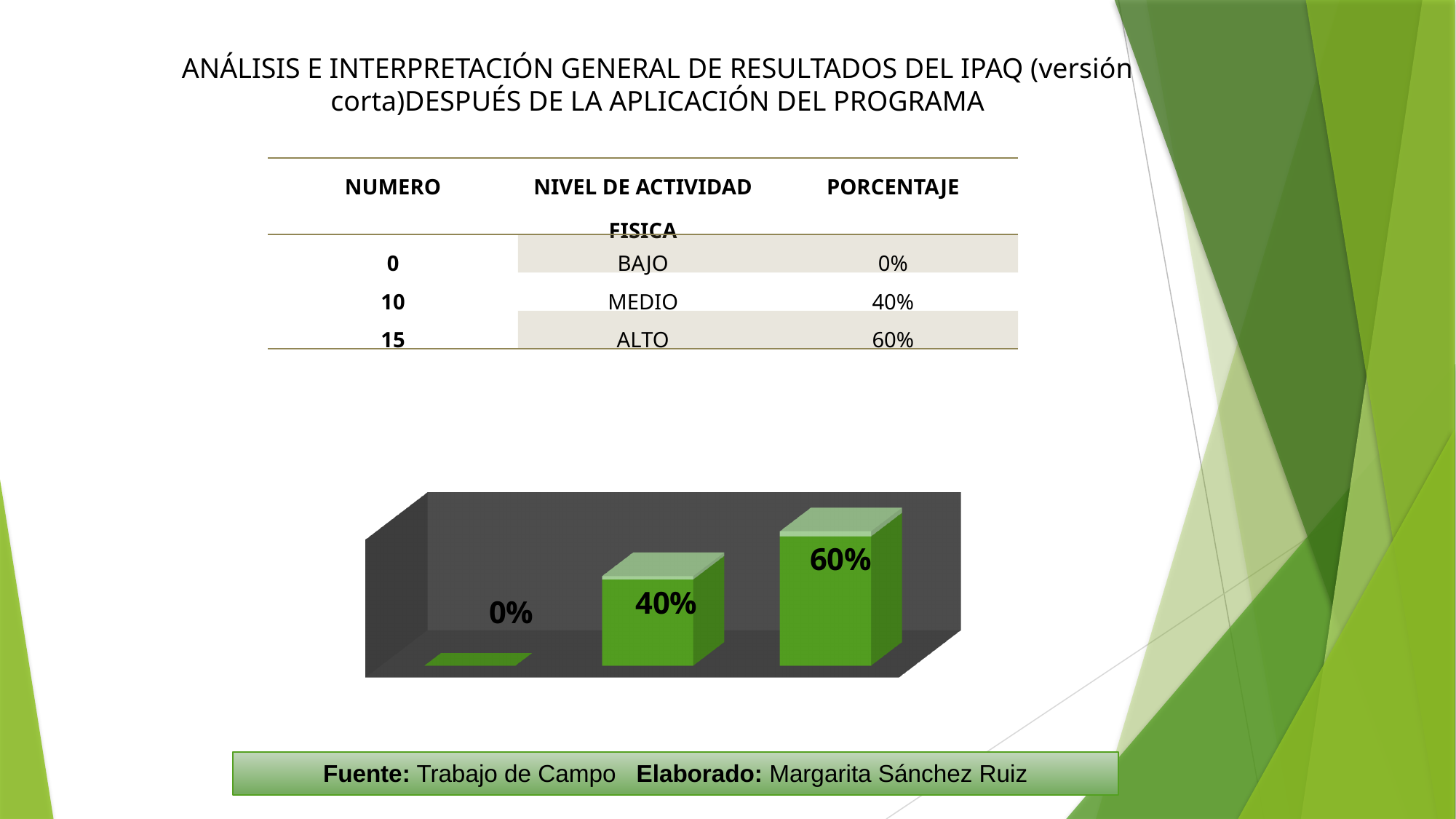
How many bars are plotted in the chart? 3 What is the value shown on the middle bar of the chart? 40% What is the difference between the values of the middle bar and the leftmost bar? 40% Which is larger, the value of the middle bar or the value of the rightmost bar? the rightmost bar Which bar in the chart has the lowest value? the leftmost bar (0%) What kind of chart is shown on the slide? bar chart What colour are the bars in the chart? green Do the bar values rise or fall from left to right across the chart? rise What is the difference between the values of the rightmost bar and the middle bar? 20% What is the value shown on the third (rightmost) bar of the chart? 60% Which bar in the chart has the highest value? the rightmost bar (60%) What is the value shown on the first (leftmost) bar of the chart? 0%